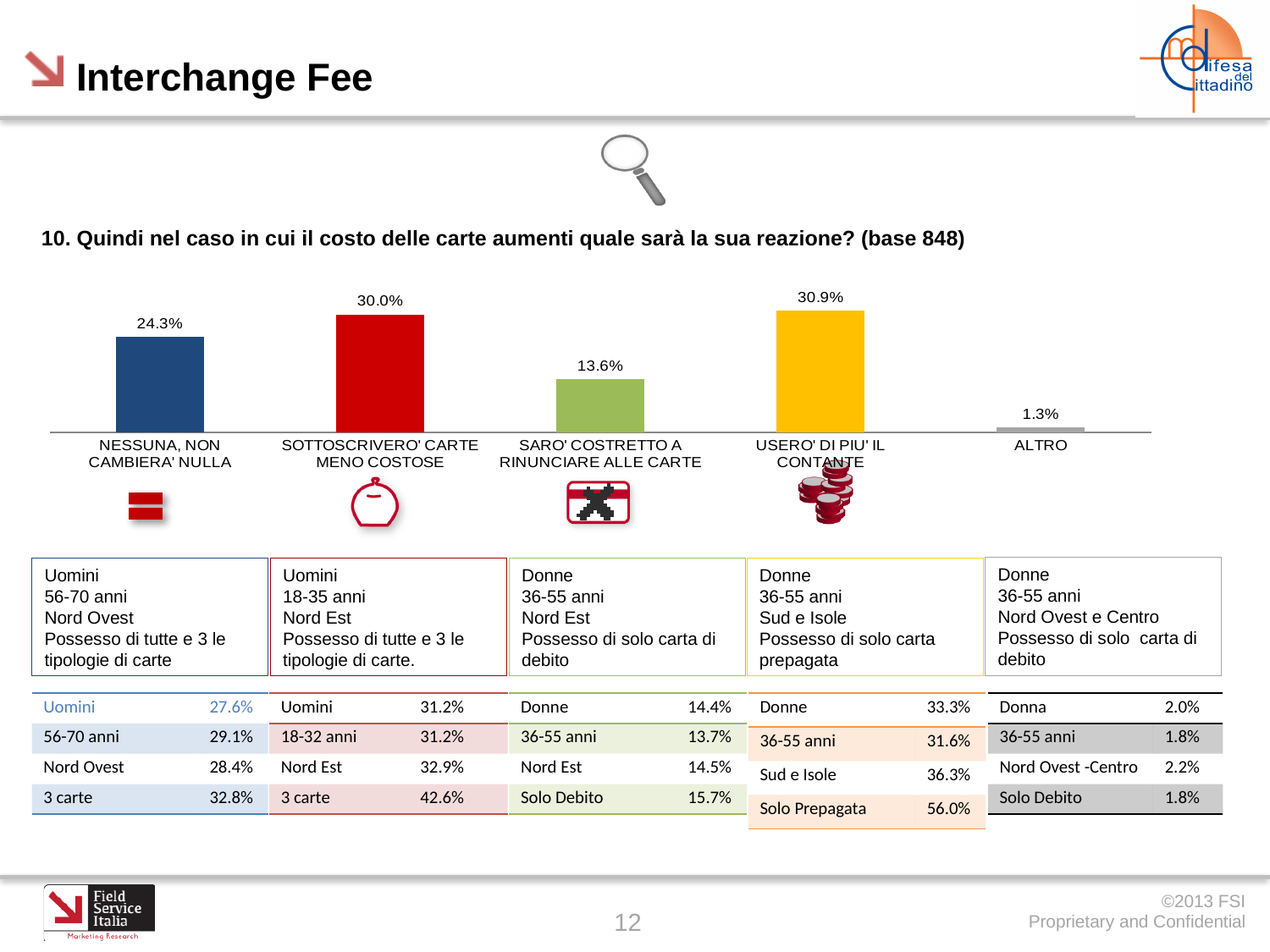
What is the value for NESSUNA, NON CAMBIERA' NULLA? 24.3% How many categories are shown in the chart? 5 Which category has the lowest value? ALTRO What is the value for SARO' COSTRETTO A RINUNCIARE ALLE CARTE? 13.6% Which is larger, NESSUNA, NON CAMBIERA' NULLA or SARO' COSTRETTO A RINUNCIARE ALLE CARTE? NESSUNA, NON CAMBIERA' NULLA What is the value for ALTRO? 1.3% What is the value for SOTTOSCRIVERO' CARTE MENO COSTOSE? 30.0% What is the difference between USERO' DI PIU' IL CONTANTE and SARO' COSTRETTO A RINUNCIARE ALLE CARTE? 17.3% What is the difference between SOTTOSCRIVERO' CARTE MENO COSTOSE and NESSUNA, NON CAMBIERA' NULLA? 5.7% What is the value for USERO' DI PIU' IL CONTANTE? 30.9% What kind of chart is shown on the slide? bar chart Which category has the highest value? USERO' DI PIU' IL CONTANTE